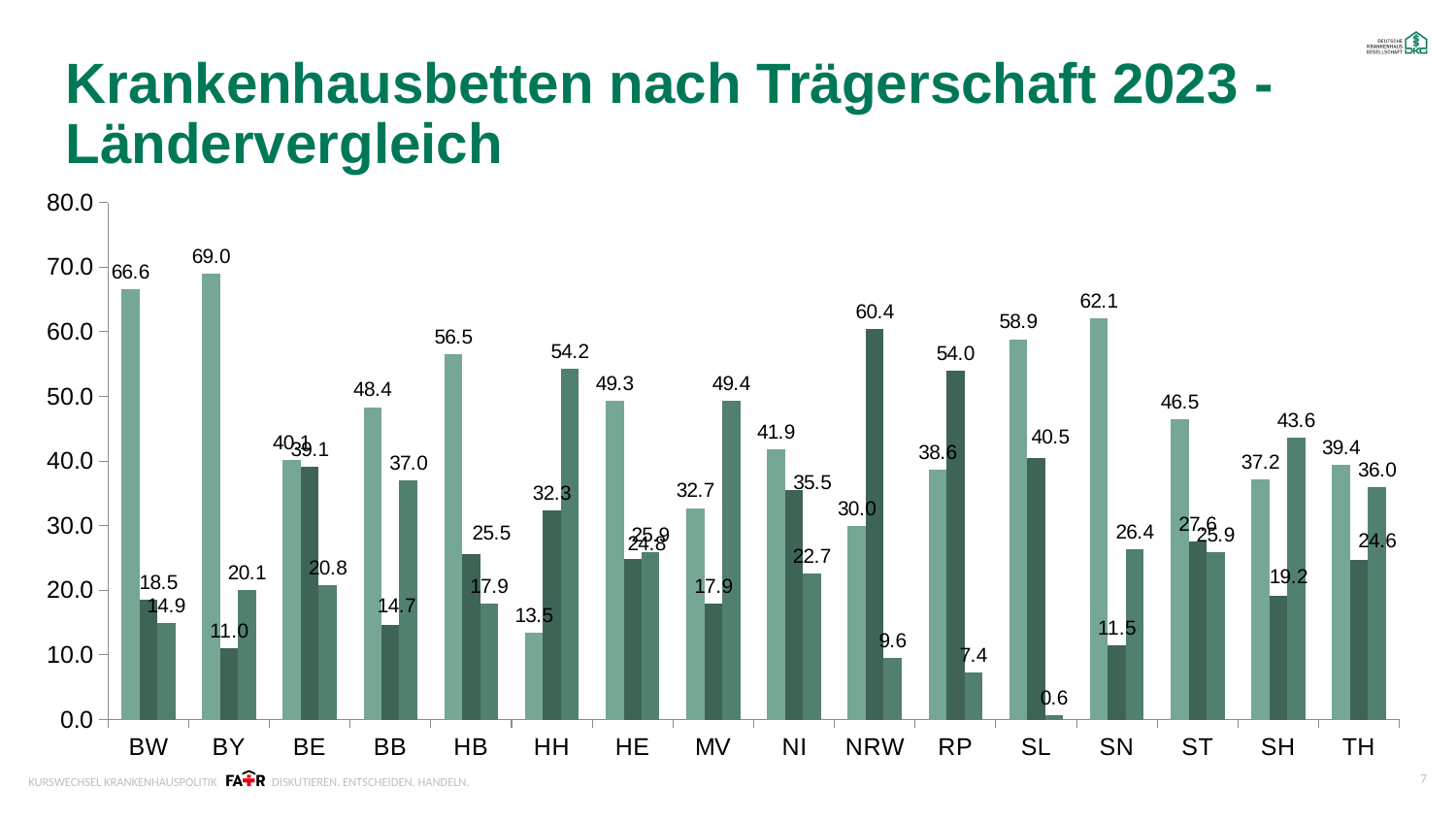
For RP, which is larger: the first bar or the second bar? the second bar What is the value of the third bar for SL? 0.6 Which category has the lowest value for the third bar? SL What is the value of the second (dark green) bar for NRW? 60.4 For HH, which is larger: the first bar or the third bar? the third bar What is the value of the first (light green) bar for BY? 69.0 Which category has the lowest value for the first (light green) bar? HH What is the difference between the first and second bars for BW? 48.1 What kind of chart is shown on the slide? bar chart Which category has the highest value for the first (light green) bar? BY How many categories (federal states) are shown on the x axis? 16 What is the title of the chart? Krankenhausbetten nach Trägerschaft 2023 - Ländervergleich